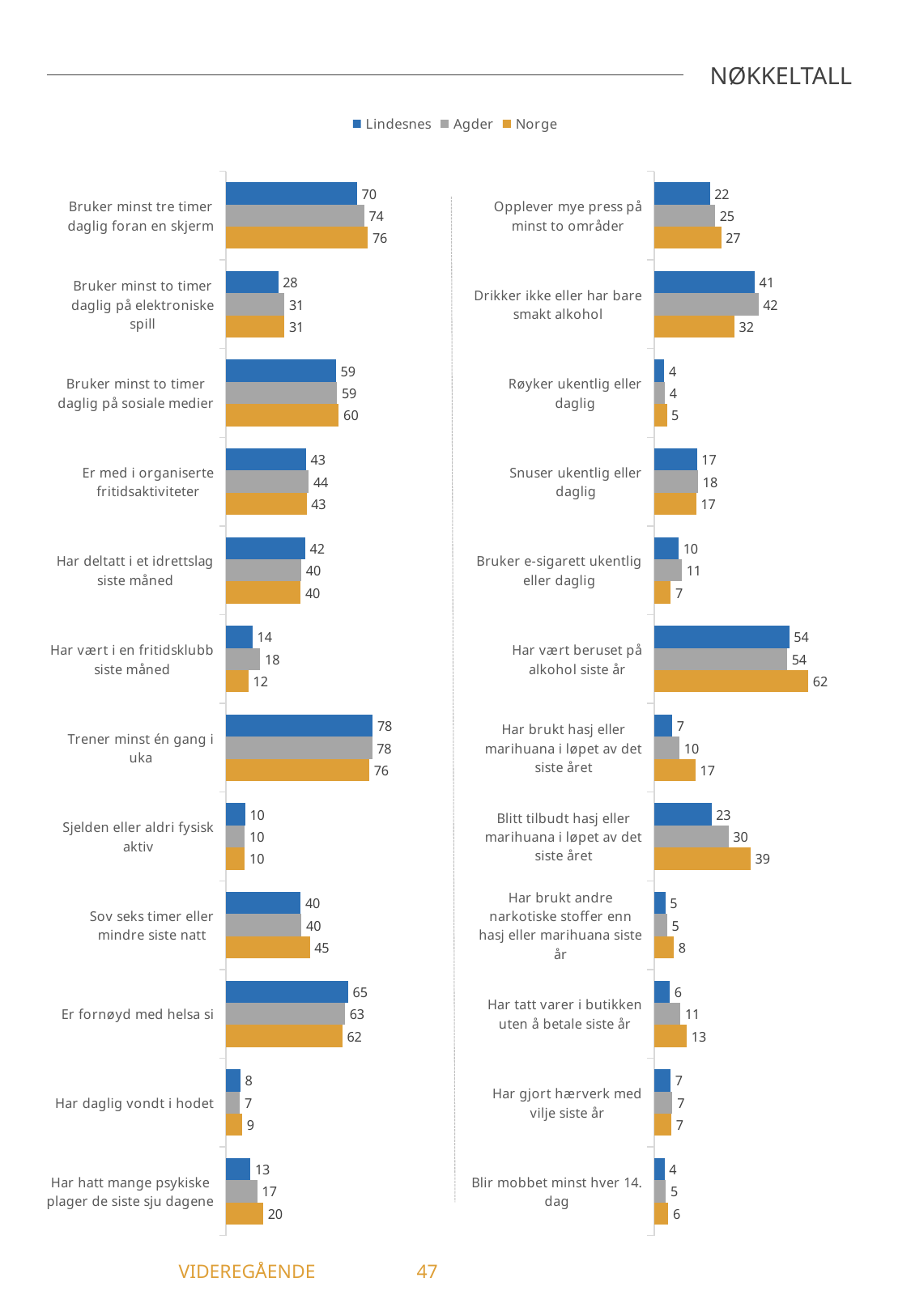
In the left chart, what is the difference between the Norge and Lindesnes values for "Har hatt mange psykiske plager de siste sju dagene"? 7 In the right chart, what is the value for Agder for "Blitt tilbudt hasj eller marihuana i løpet av det siste året"? 30 In the right chart, what is the difference between the Norge and Lindesnes values for "Har brukt hasj eller marihuana i løpet av det siste året"? 10 How many categories does the left chart show? 12 In the right chart, which category has the lowest value for Norge? Røyker ukentlig eller daglig What kind of chart is the right chart? Bar chart In the right chart, which is larger for "Drikker ikke eller har bare smakt alkohol": the Agder value or the Norge value? Agder In the right chart, what is the value for Norge for "Har vært beruset på alkohol siste år"? 62 In the left chart, which is larger for "Har vært i en fritidsklubb siste måned": the Agder value or the Norge value? Agder How many series does the legend list? 3 In the left chart, which category has the highest value for Lindesnes? Trener minst én gang i uka In the left chart, what is the value for Lindesnes for "Bruker minst tre timer daglig foran en skjerm"? 70